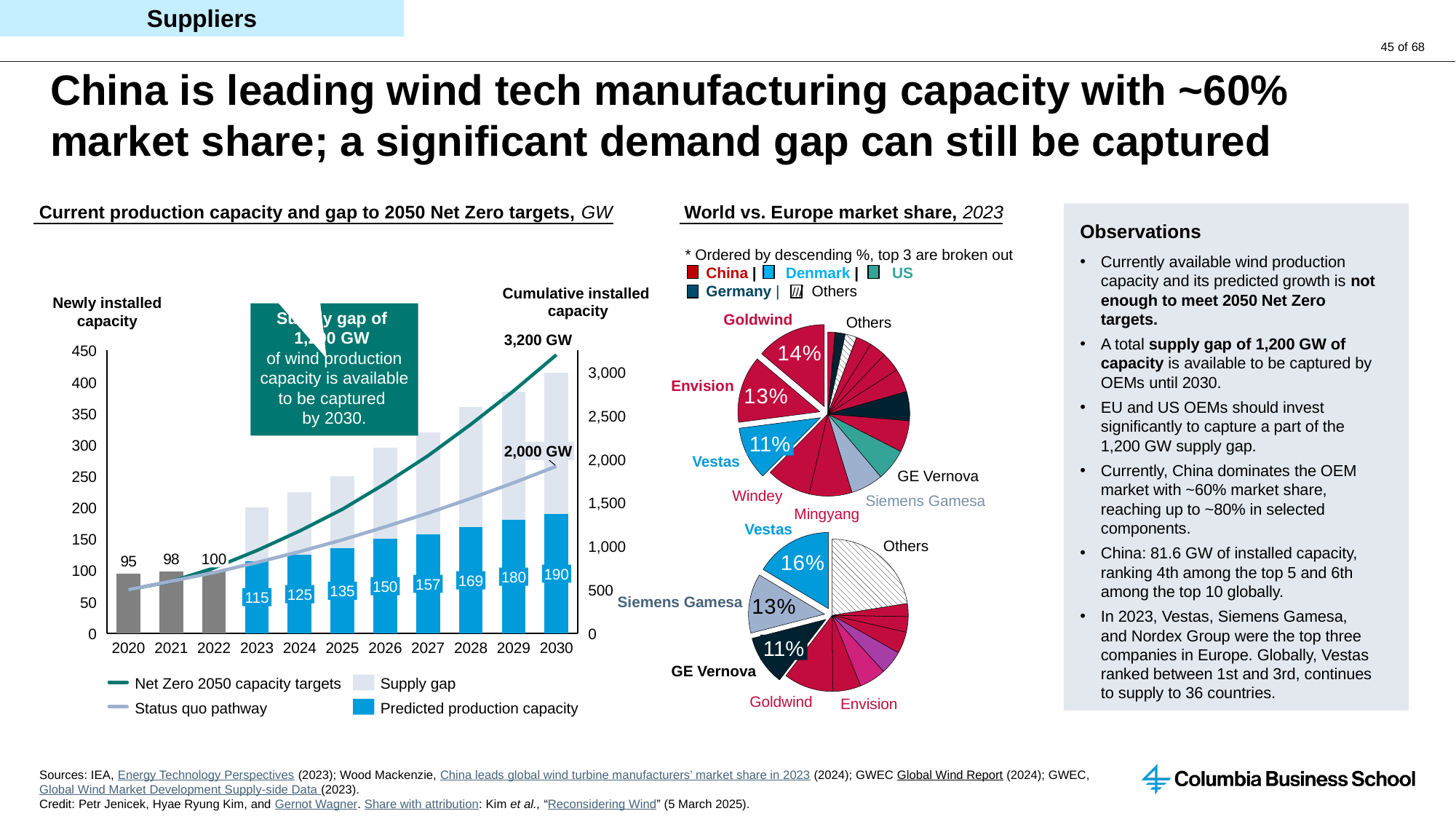
In the 'Current production capacity and gap to 2050 Net Zero targets' chart, which year has the highest predicted production capacity? 2030 In the 'Current production capacity and gap to 2050 Net Zero targets' chart, what is the difference between the predicted production capacity in 2030 and in 2023? 75 In the 'Current production capacity and gap to 2050 Net Zero targets' chart, what is the difference between the 2030 Net Zero 2050 target and the 2030 status quo pathway value? 1,200 GW In the 'Current production capacity and gap to 2050 Net Zero targets' chart, what is the newly installed capacity value shown for 2020? 95 In the World market share pie chart (top pie), what share does Goldwind hold? 14% In the 'Current production capacity and gap to 2050 Net Zero targets' chart, what is the predicted production capacity for 2030? 190 In the 'Current production capacity and gap to 2050 Net Zero targets' chart, how many entries does the legend list? 4 What kind of chart is used for the 'World vs. Europe market share, 2023' data? pie chart In the 'Current production capacity and gap to 2050 Net Zero targets' chart, how many years are shown on the x axis? 11 In the 'Current production capacity and gap to 2050 Net Zero targets' chart, what cumulative installed capacity does the Net Zero 2050 capacity targets line reach in 2030? 3,200 GW Is Vestas's market share larger in the World pie chart or in the Europe pie chart? Europe In the 'Current production capacity and gap to 2050 Net Zero targets' chart, does the predicted production capacity rise or fall from 2023 to 2030? rise